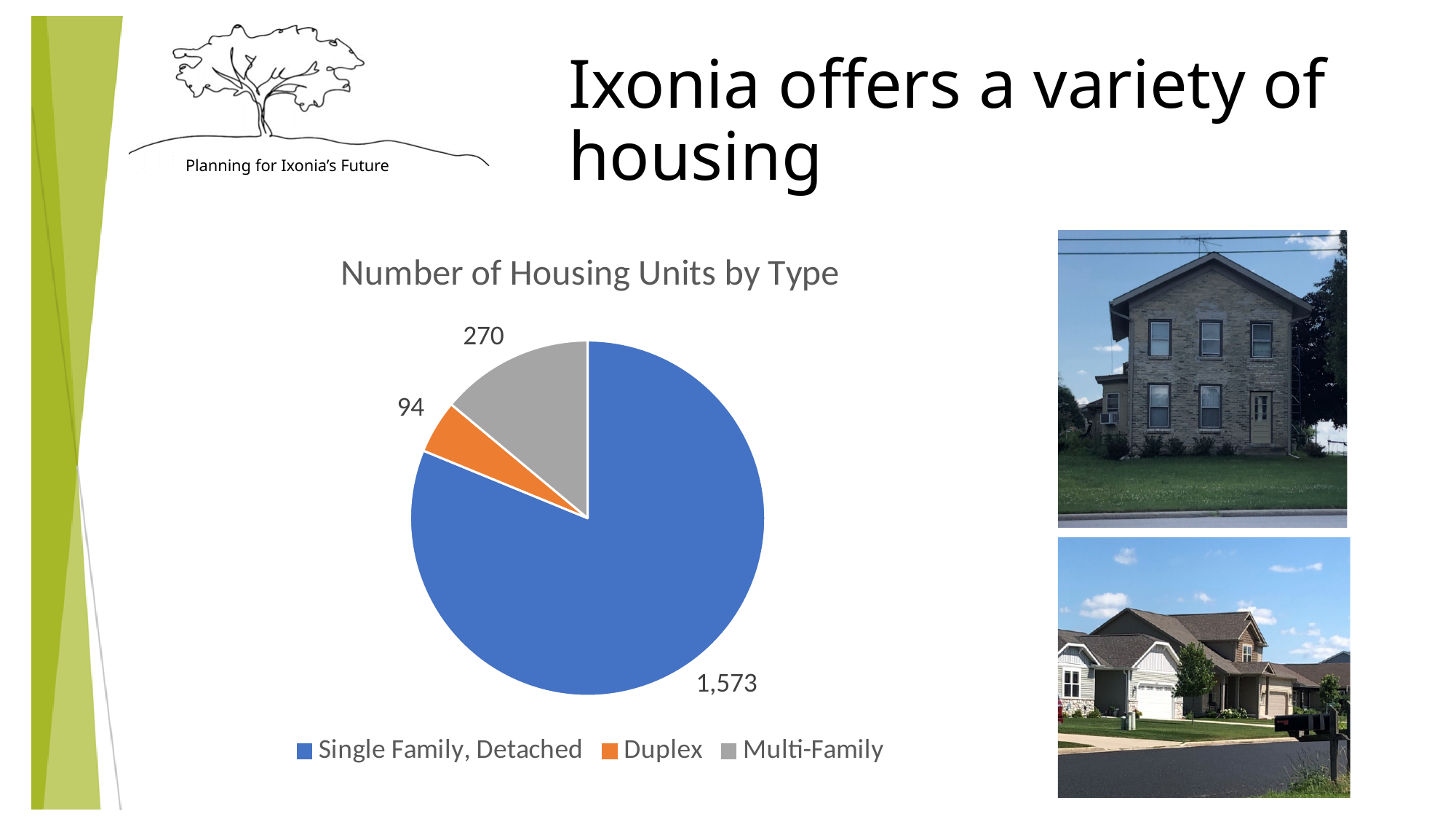
How many housing units are Single Family, Detached? 1,573 What type of chart is shown on the slide? Pie chart How many housing types are shown in the pie chart? 3 How many housing units are Multi-Family? 270 Which housing type has the largest number of units? Single Family, Detached What is the title of the chart? Number of Housing Units by Type How many more Multi-Family units are there than Duplex units? 176 How many housing units are Duplex? 94 Which housing type has the smallest number of units? Duplex What is the total number of housing units shown in the chart? 1,937 Which has more units, Multi-Family or Duplex? Multi-Family Which colour represents Duplex in the pie chart? Orange